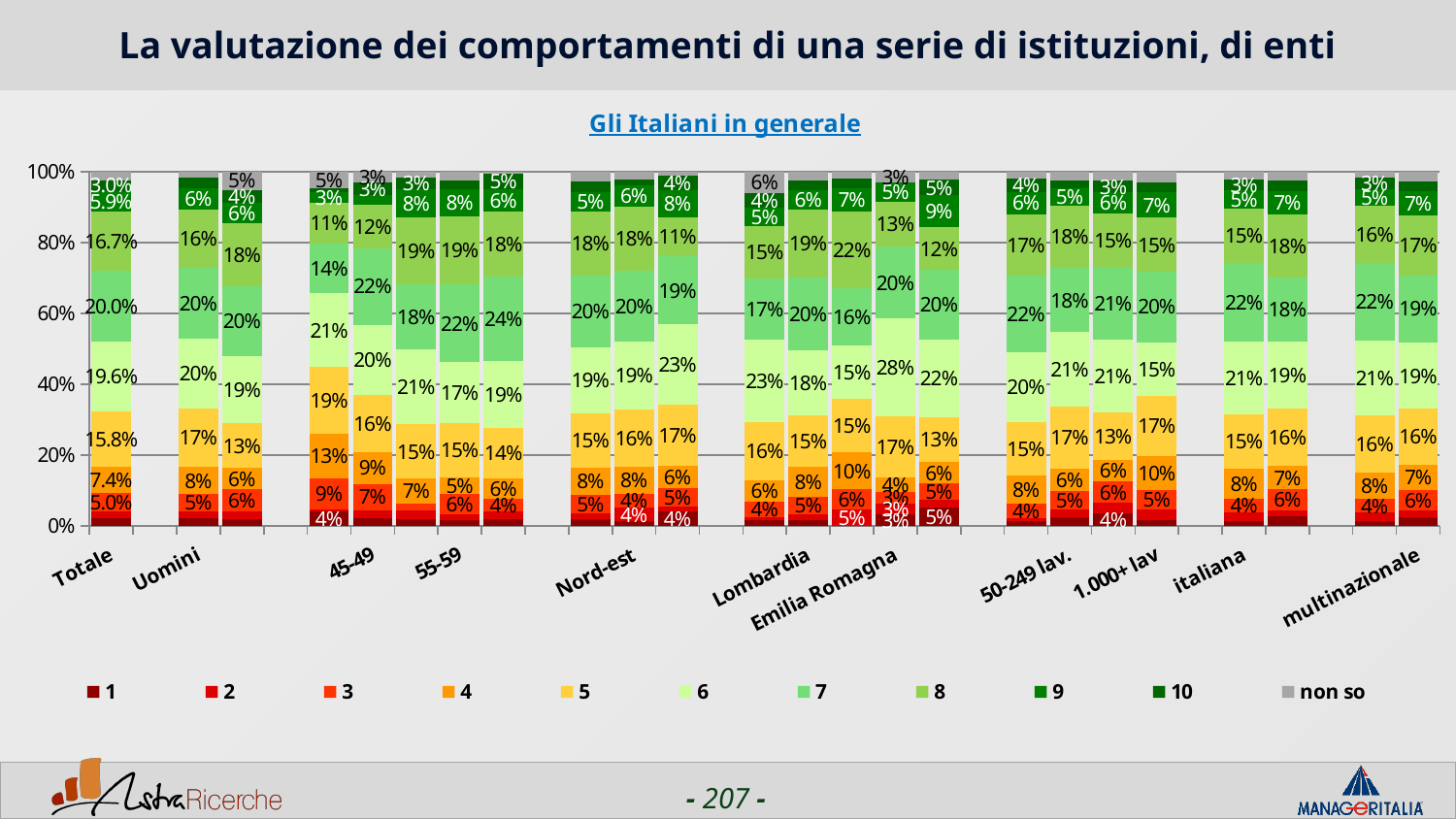
How many series does the legend list? 11 In the Totale bar, which is larger: the segment labeled 20.0% or the segment labeled 16.7%? 20.0% In the Totale bar, what is the difference between the segments labeled 20.0% and 16.7%? 3.3% What is the highest value shown on the vertical axis? 100% In the Totale bar, what is the value of the topmost labeled segment? 3.0% In the Totale bar, what is the largest labeled segment value? 20.0% What kind of chart is shown on the slide? stacked bar chart In the Totale bar, what is the value of the segment labeled just above the 5.0% segment? 7.4% What is the subtitle shown above the chart? Gli Italiani in generale What is the last entry in the chart legend? non so